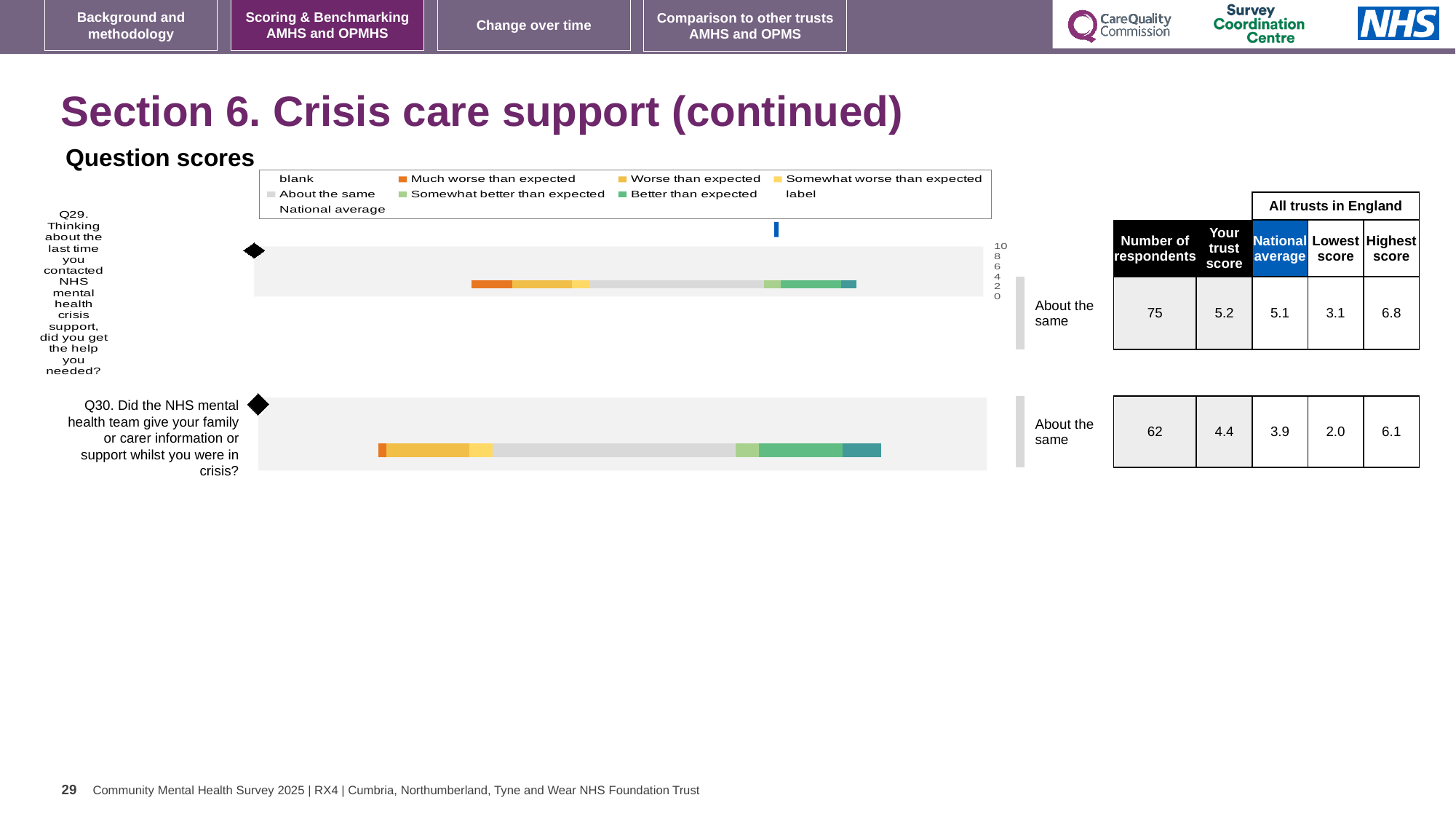
What benchmark category is shown next to the bar for Q30? About the same What is the national average for Q30 in the table beside the chart? 3.9 Which question has the higher 'Highest score' across all trusts in England? Q29 What kind of chart is shown under 'Question scores'? bar chart Which question has the higher trust score, Q29 or Q30? Q29 How many questions (bars) are plotted in the chart? 2 What benchmark category is shown next to the bar for Q29? About the same How many respondents answered Q30? 62 What is the trust score for Q29 in the table beside the chart? 5.2 Which legend entry is shown in light grey? About the same What is the difference between the trust score and the national average for Q30? 0.5 Which legend entry is shown in orange? Much worse than expected